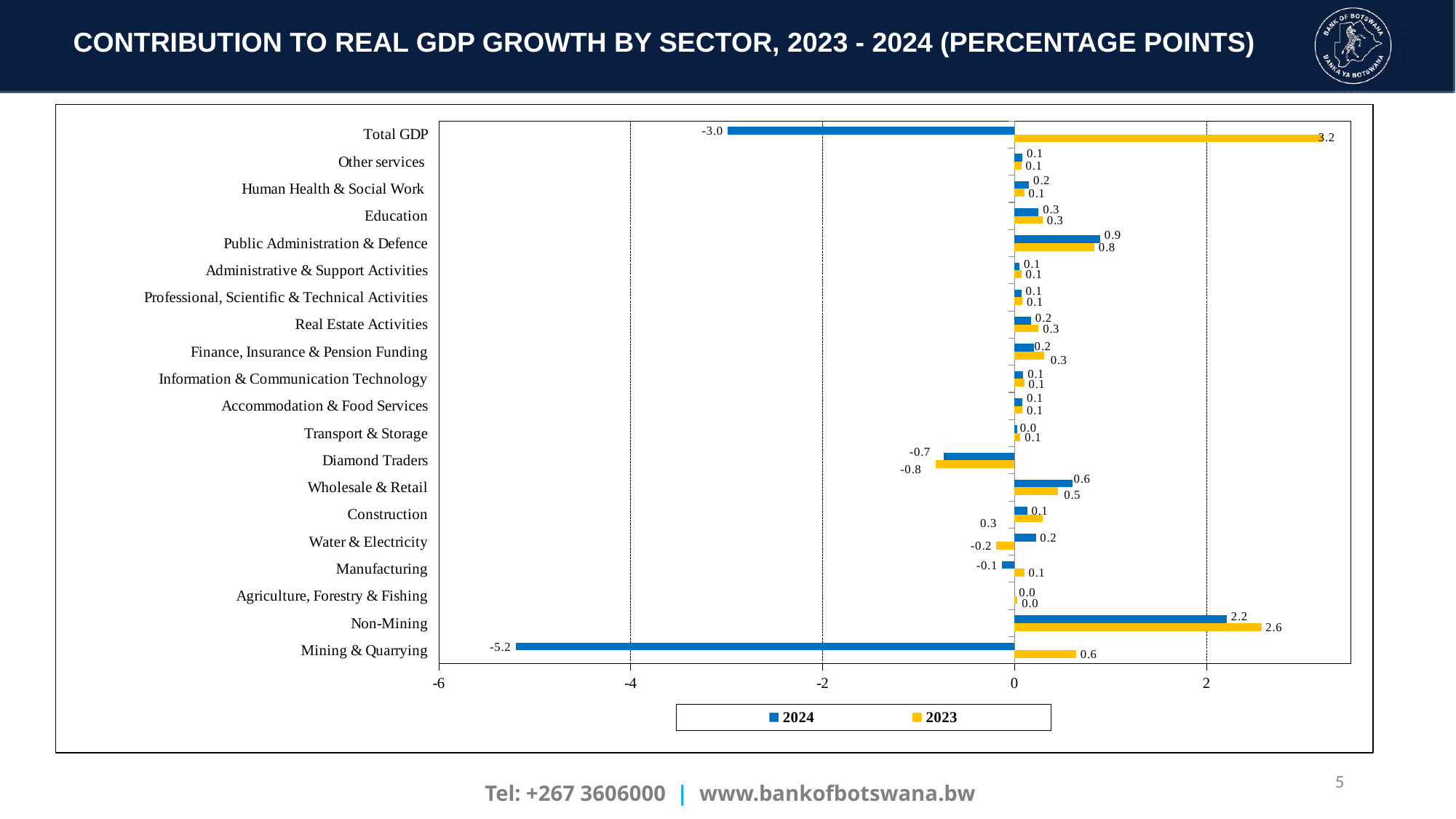
What is the difference between the 2023 and 2024 values for Non-Mining? 0.4 What is the 2023 value for Water & Electricity? -0.2 How many series does the legend list? 2 What is the 2024 value for Public Administration & Defence? 0.9 What is the 2023 value for Total GDP? 3.2 What type of chart is shown on the slide? Bar chart Which colour represents the 2023 series? Yellow Which is larger for Diamond Traders, the 2024 value or the 2023 value? 2024 What is the 2023 value for Non-Mining? 2.6 Which sector has the lowest 2024 value? Mining & Quarrying Which category has the highest 2023 value? Total GDP What is the 2024 value for Mining & Quarrying? -5.2